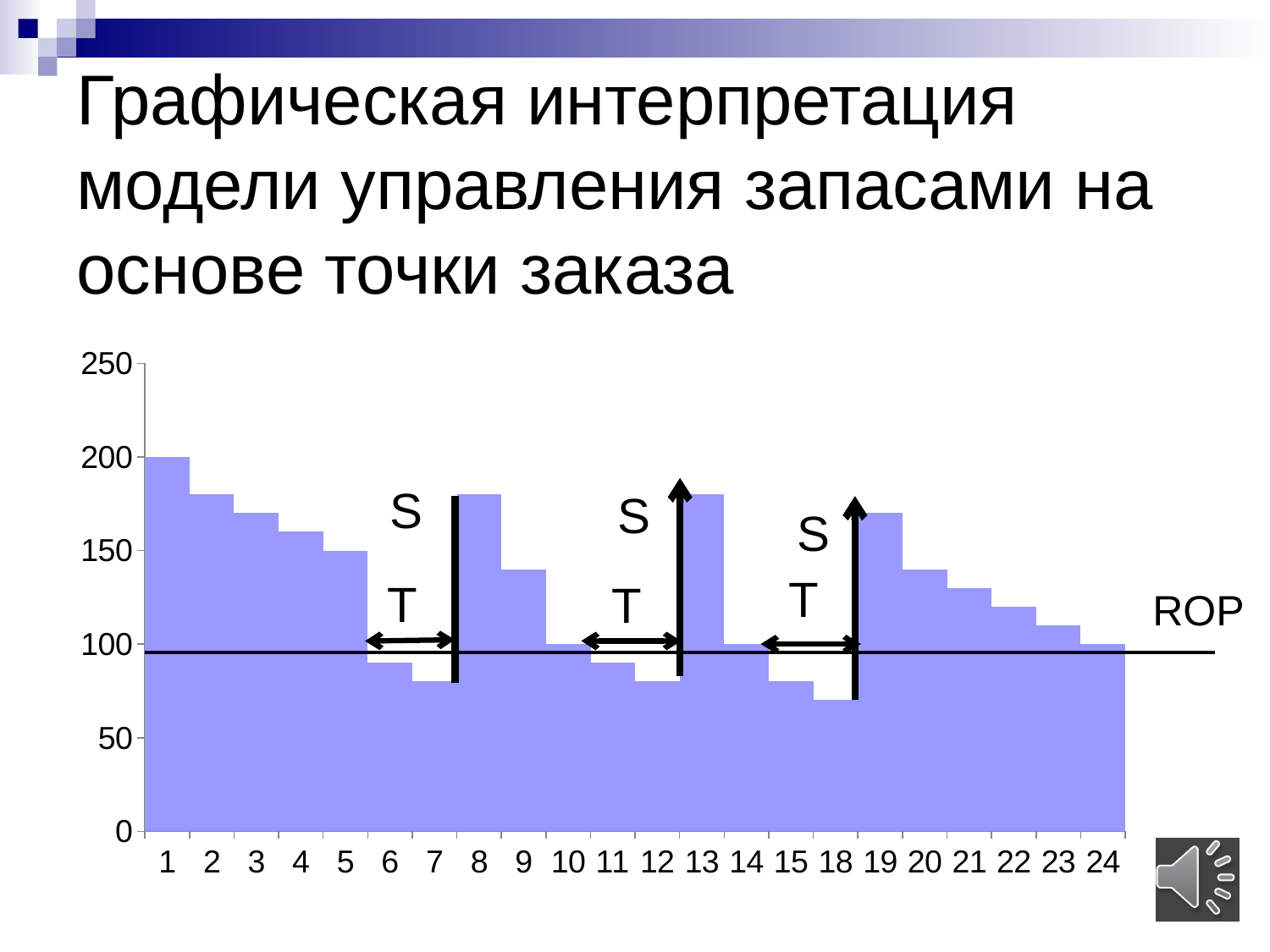
Is the value for category 8 greater or less than 150? greater What label is written next to the horizontal line drawn across the chart? ROP What is the highest value shown on the y axis of the chart? 250 Do the values rise or fall from category 1 to category 5? fall How many categories are labelled on the x axis of the chart? 22 Which is larger, the value for category 5 or the value for category 6? category 5 Is the value for category 7 greater or less than 100? less What is the value for category 1 in the chart? 200 Is the value for category 18 greater or less than 100? less Which category has the highest value in the chart? 1 What kind of chart is shown on the slide? bar chart